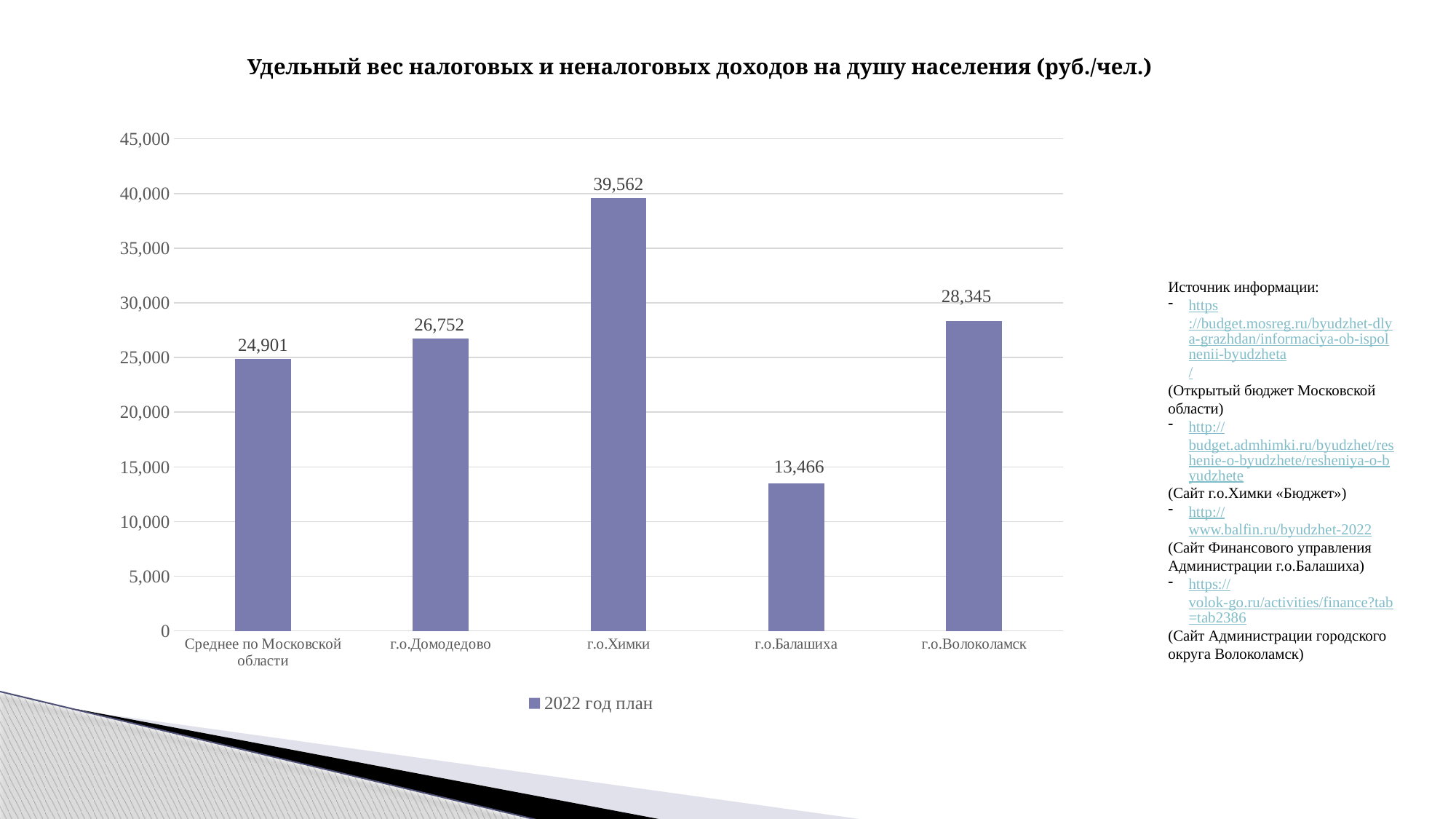
What kind of chart is shown on the slide? bar chart Which category has the lowest value? г.о.Балашиха What series does the legend list? 2022 год план Is the value for г.о.Волоколамск greater or less than 25,000? greater What is the value for г.о.Химки? 39,562 What is the value for Среднее по Московской области? 24,901 What is the difference between the values for г.о.Химки and г.о.Балашиха? 26,096 Which is larger, the value for г.о.Домодедово or the value for Среднее по Московской области? г.о.Домодедово Which category has the highest value? г.о.Химки What is the difference between the values for г.о.Волоколамск and г.о.Домодедово? 1,593 How many categories are shown on the x axis? 5 What is the value for г.о.Балашиха? 13,466